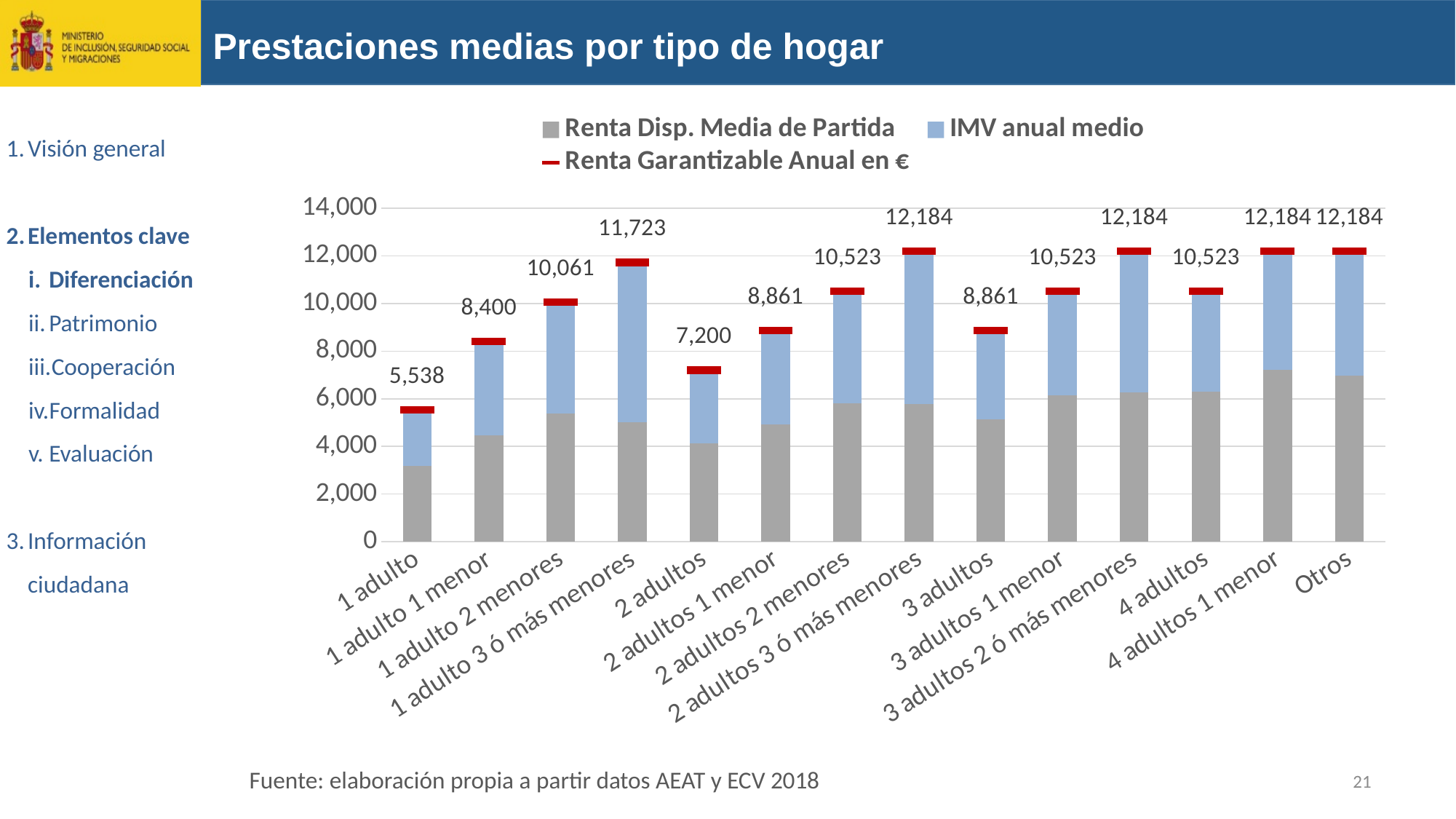
Which household type has the lowest Renta Garantizable Anual en € value? 1 adulto What kind of chart is shown on the slide? bar chart How many series does the chart legend list? 3 What is the Renta Garantizable Anual en € value for '1 adulto 3 ó más menores'? 11,723 What is the difference between the Renta Garantizable Anual values for '1 adulto 1 menor' and '1 adulto'? 2,862 What is the Renta Garantizable Anual en € value for '2 adultos'? 7,200 Is the Renta Disp. Media de Partida value for '1 adulto' greater or less than 4,000? less What is the Renta Garantizable Anual en € value for the '1 adulto' household type? 5,538 Which has a larger Renta Garantizable Anual value: '1 adulto 2 menores' or '2 adultos 2 menores'? 2 adultos 2 menores Is the Renta Disp. Media de Partida value for 'Otros' greater or less than 6,000? greater How many household types are shown on the x axis of the chart? 14 What is the difference between the Renta Garantizable Anual values for '2 adultos 2 menores' and '2 adultos 1 menor'? 1,662